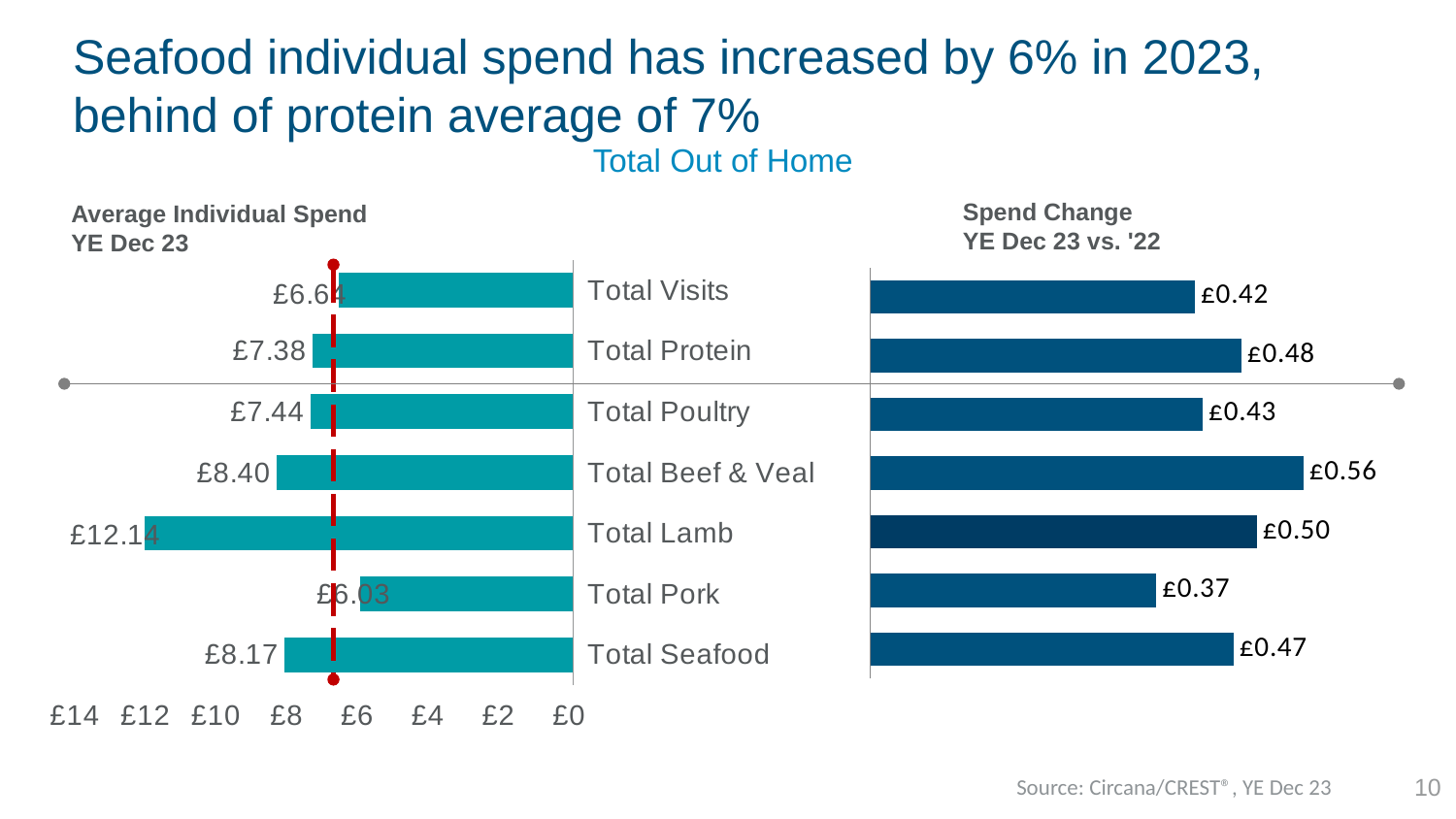
In the Average Individual Spend YE Dec 23 chart, what is the value for Total Beef & Veal? £8.40 In the Average Individual Spend YE Dec 23 chart, what is the difference between Total Beef & Veal and Total Seafood? £0.23 In the Average Individual Spend YE Dec 23 chart, which category has the highest value? Total Lamb In the Spend Change YE Dec 23 vs. '22 chart, which category has the lowest value? Total Pork In the Spend Change YE Dec 23 vs. '22 chart, what is the difference between Total Beef & Veal and Total Pork? £0.19 In the Spend Change YE Dec 23 vs. '22 chart, what is the value for Total Seafood? £0.47 How many categories are shown in the Average Individual Spend YE Dec 23 chart? 7 In the Spend Change YE Dec 23 vs. '22 chart, which is larger, Total Lamb or Total Poultry? Total Lamb In the Average Individual Spend YE Dec 23 chart, which category has the lowest value? Total Pork In the Spend Change YE Dec 23 vs. '22 chart, which category has the highest value? Total Beef & Veal In the Average Individual Spend YE Dec 23 chart, is the value for Total Lamb greater or less than £10? greater In the Average Individual Spend YE Dec 23 chart, what is the value for Total Seafood? £8.17